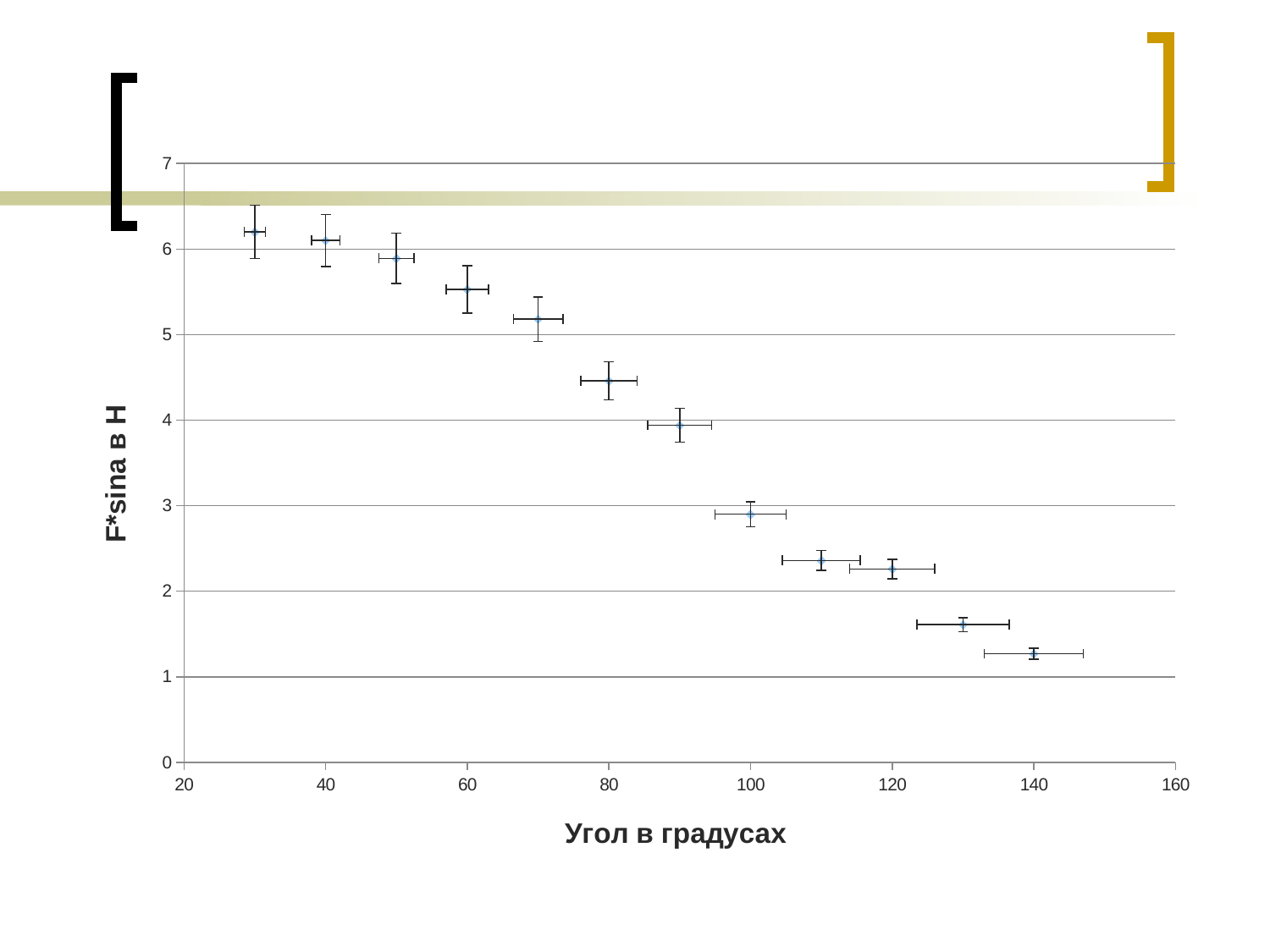
How many data points are plotted on the chart? 12 Do the values of F*sina rise or fall as the angle increases along the x axis? fall What is the label of the y axis? F*sina в Н Is the value for the point at 80 degrees greater or less than 4? greater Is the value for the point at 130 degrees greater or less than 2? less What is the label of the x axis? Угол в градусах Is the value for the point at 140 degrees greater or less than 2? less Which point has the larger value: the one at 50 degrees or the one at 110 degrees? 50 degrees At which angle is the plotted value of F*sina lowest? 140 What kind of chart is shown on the slide? scatter chart At which angle is the plotted value of F*sina highest? 30